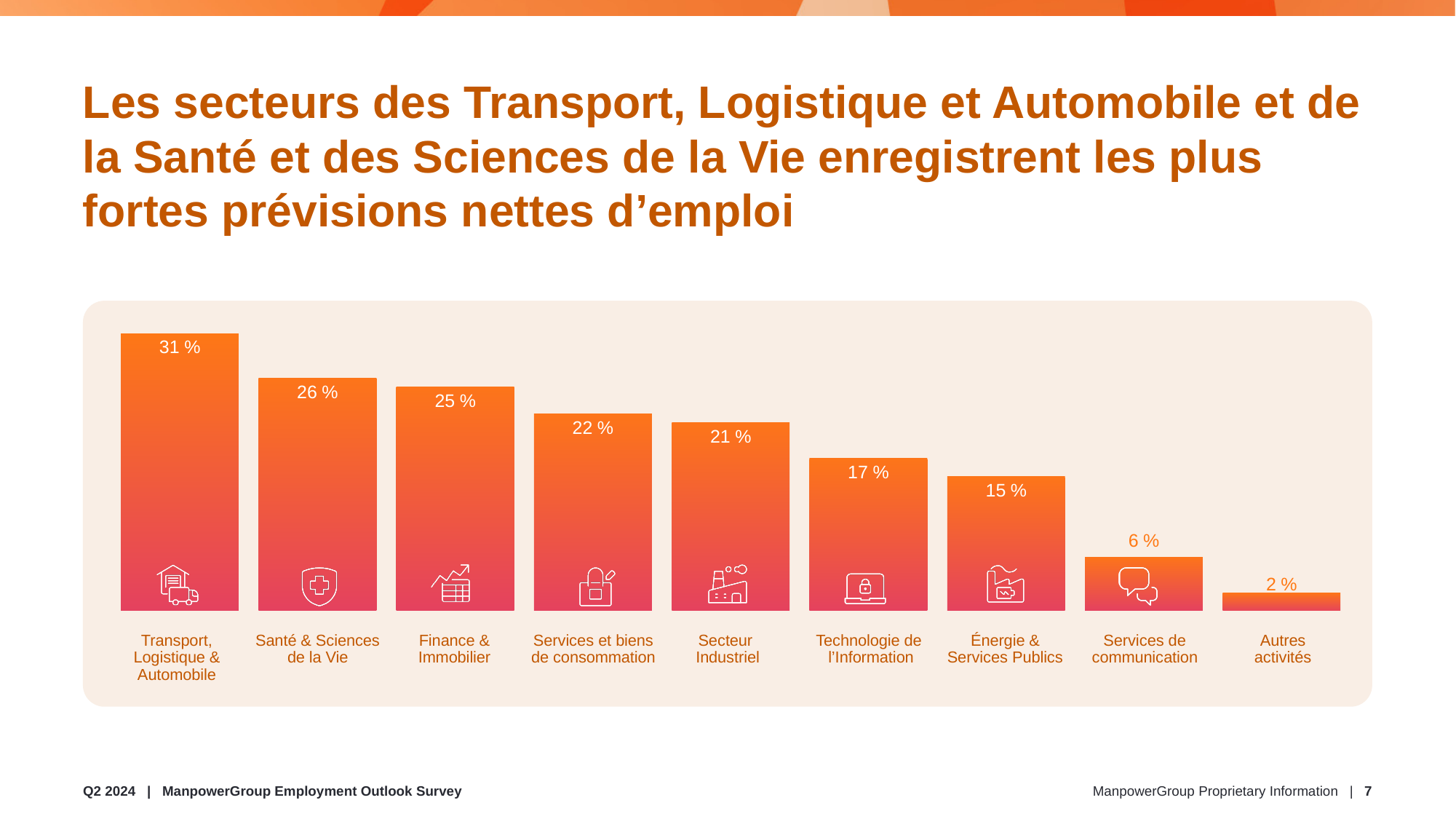
What is the value for Secteur Industriel? 21 % Which category has the lowest value? Autres activités What is the value for Transport, Logistique & Automobile? 31 % How many categories are shown in the chart? 9 What is the difference between Transport, Logistique & Automobile and Autres activités? 29 % What kind of chart is shown on the slide? Bar chart Which is larger, Technologie de l'Information or Énergie & Services Publics? Technologie de l'Information What is the value for Services et biens de consommation? 22 % What is the value for Services de communication? 6 % Which category has the highest value? Transport, Logistique & Automobile What is the difference between Santé & Sciences de la Vie and Finance & Immobilier? 1 % Do the values rise or fall from left to right across the categories? Fall